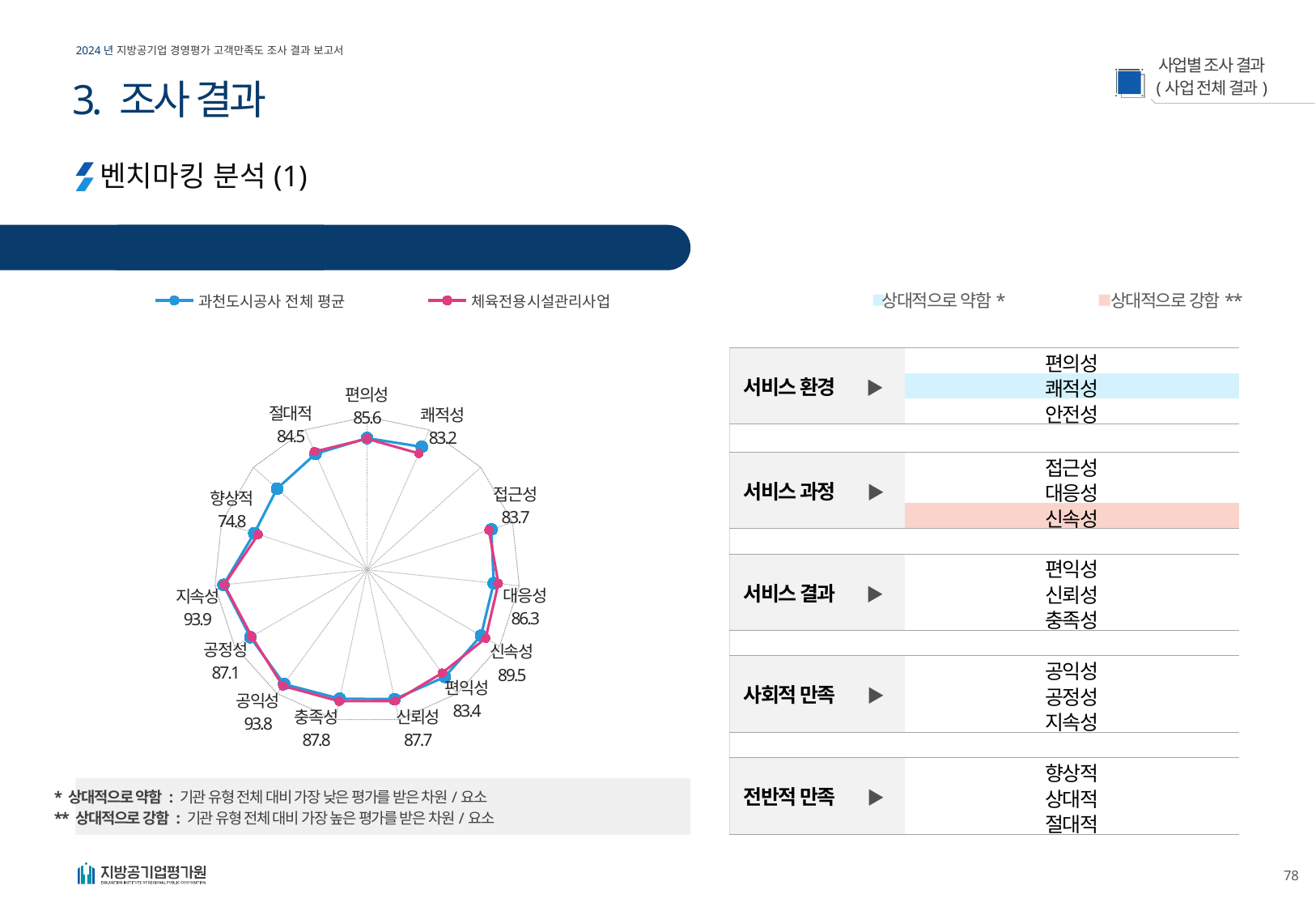
What kind of chart is shown on the slide? radar chart Which category has the lowest printed value on the radar chart? 향상적 Which has the larger printed value, 대응성 or 쾌적성? 대응성 What are the two series named in the chart legend? 과천도시공사 전체 평균, 체육전용시설관리사업 What value is printed next to 지속성 on the radar chart? 93.9 What value is printed next to 편의성 on the radar chart? 85.6 How many categories (axes) are labeled on the radar chart? 13 What is the difference between the printed values for 신속성 and 편익성? 6.1 How many series does the chart legend list? 2 What value is printed next to 향상적 on the radar chart? 74.8 In the table on the right, which item is highlighted as 상대적으로 강함? 신속성 What value is printed next to 신속성 on the radar chart? 89.5